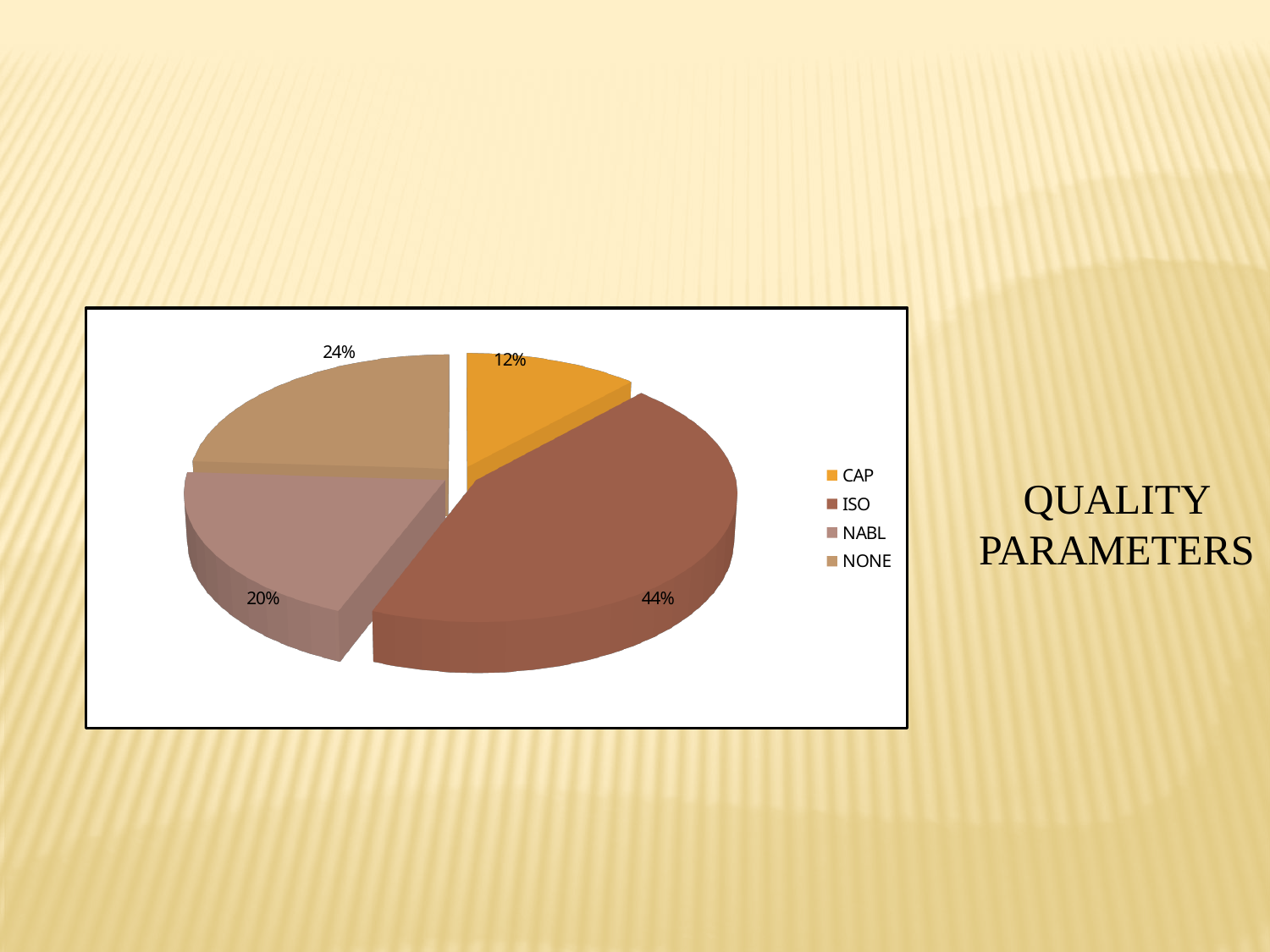
What share of the pie does NONE have? 24% What is the difference in percentage points between the ISO and CAP slices? 32 How many categories are shown in the pie chart? 4 What kind of chart is shown on the slide? Pie chart What share of the pie does NABL have? 20% What share of the pie does ISO have? 44% What text appears to the right of the chart on the slide? QUALITY PARAMETERS Which is larger, the NONE slice or the NABL slice? NONE Which category has the largest slice of the pie? ISO Which category has the smallest slice of the pie? CAP What is the difference in percentage points between the NONE and NABL slices? 4